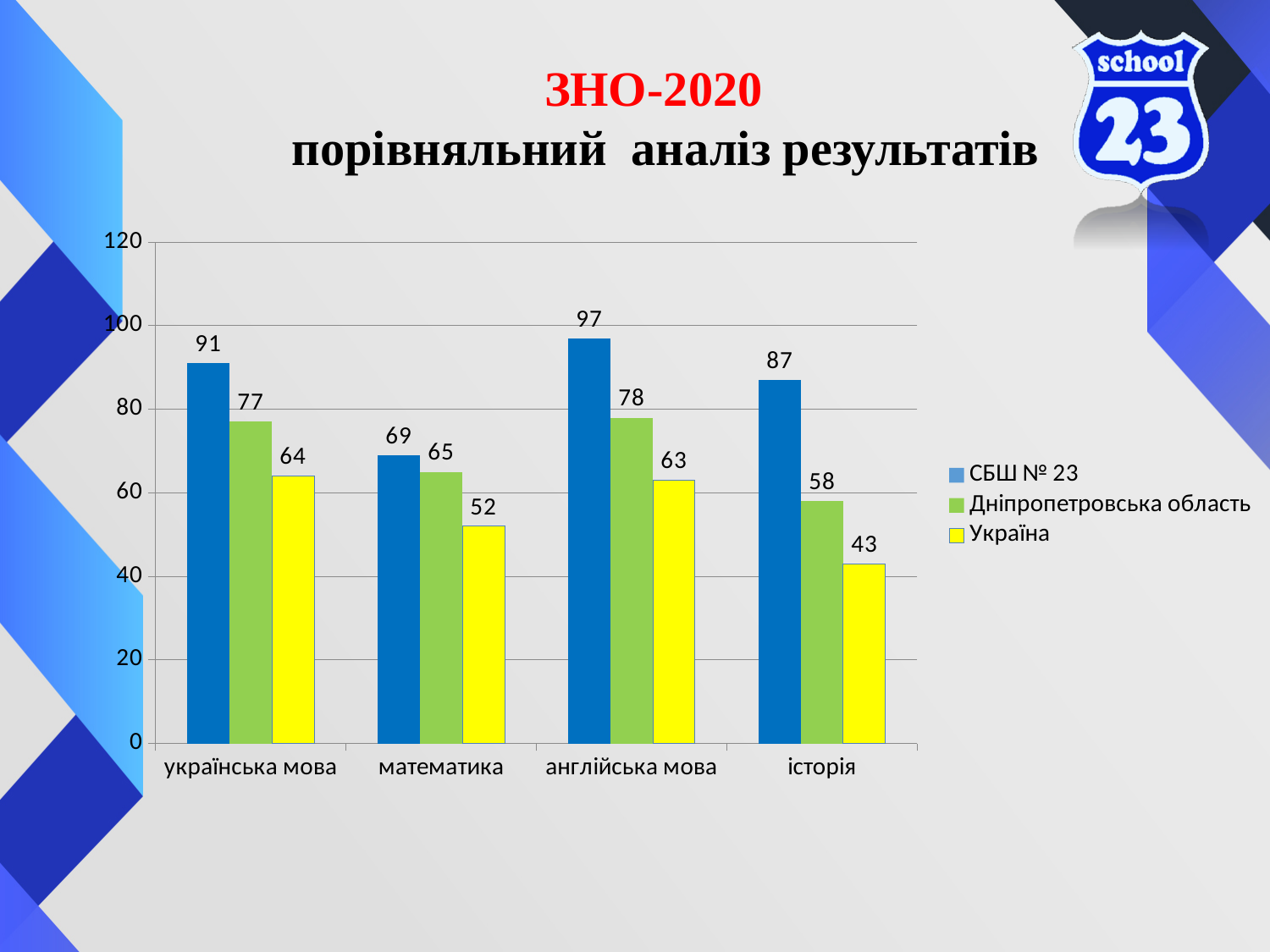
How many subjects are shown on the x axis? 4 What is the value for Дніпропетровська область in історія? 58 What is the value for СБШ № 23 in англійська мова? 97 Which is larger: Дніпропетровська область in математика or Україна in українська мова? Дніпропетровська область in математика Which subject has the lowest value for Україна? історія Which colour represents Україна in the chart? yellow What is the difference between СБШ № 23 and Україна in історія? 44 What is the value for Україна in математика? 52 What kind of chart is shown on the slide? bar chart What is the difference between СБШ № 23 and Дніпропетровська область in українська мова? 14 How many series does the legend list? 3 Which subject has the highest value for СБШ № 23? англійська мова